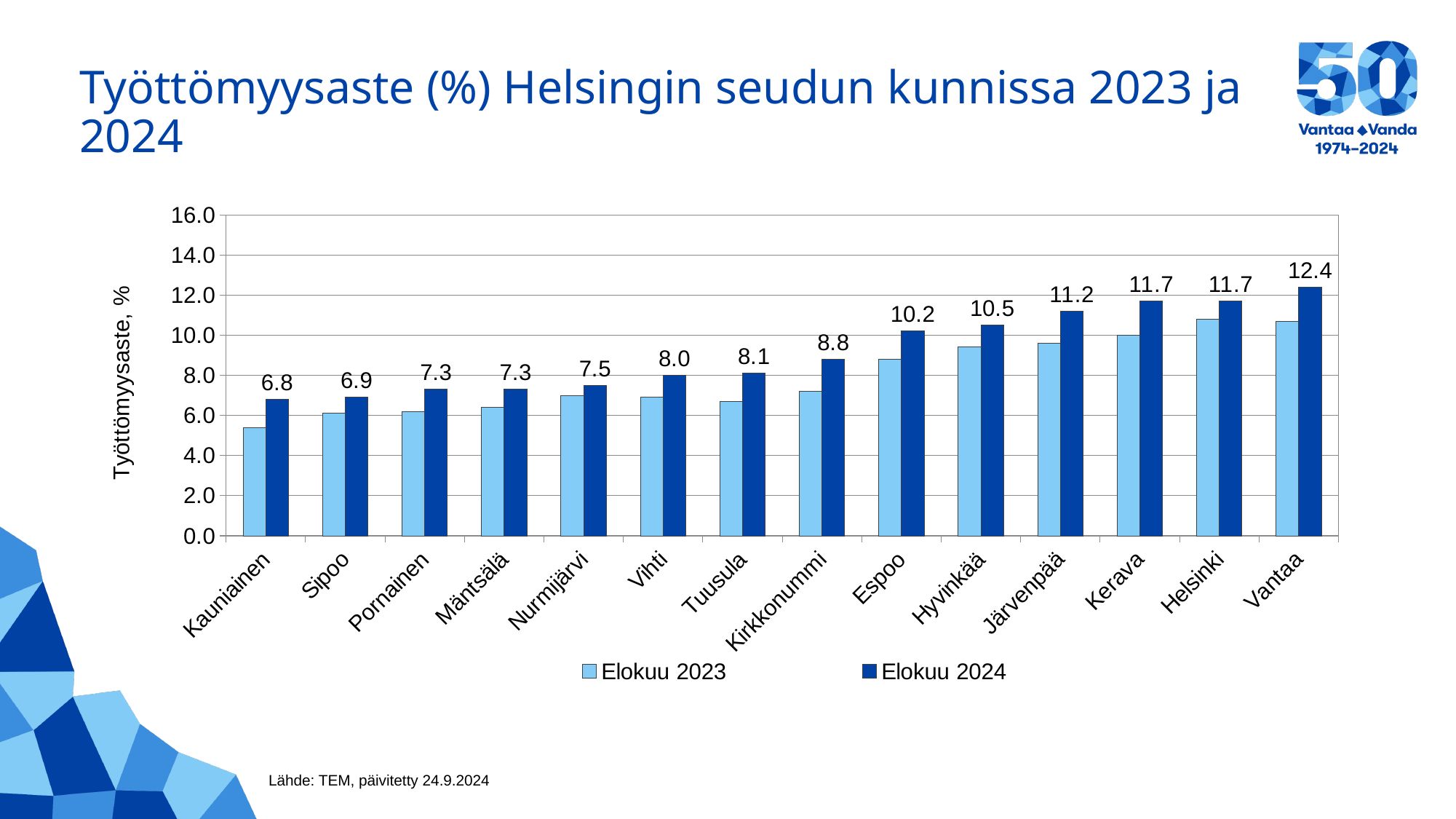
Is the Elokuu 2023 value for Helsinki greater or less than 10.0? greater How many series does the legend list? 2 Do the Elokuu 2024 values rise or fall from left to right along the x axis? rise Which has a higher Elokuu 2024 value, Hyvinkää or Tuusula? Hyvinkää What is the Elokuu 2024 value for Kirkkonummi? 8.8 What kind of chart is shown on the slide? bar chart How many municipalities are shown on the x axis? 14 Which municipality has the lowest unemployment rate in Elokuu 2024? Kauniainen Which municipality has the highest unemployment rate in Elokuu 2024? Vantaa What is the unemployment rate for Vantaa in Elokuu 2024? 12.4 What is the Elokuu 2024 value for Espoo? 10.2 What is the difference between the Elokuu 2024 values for Vantaa and Helsinki? 0.7